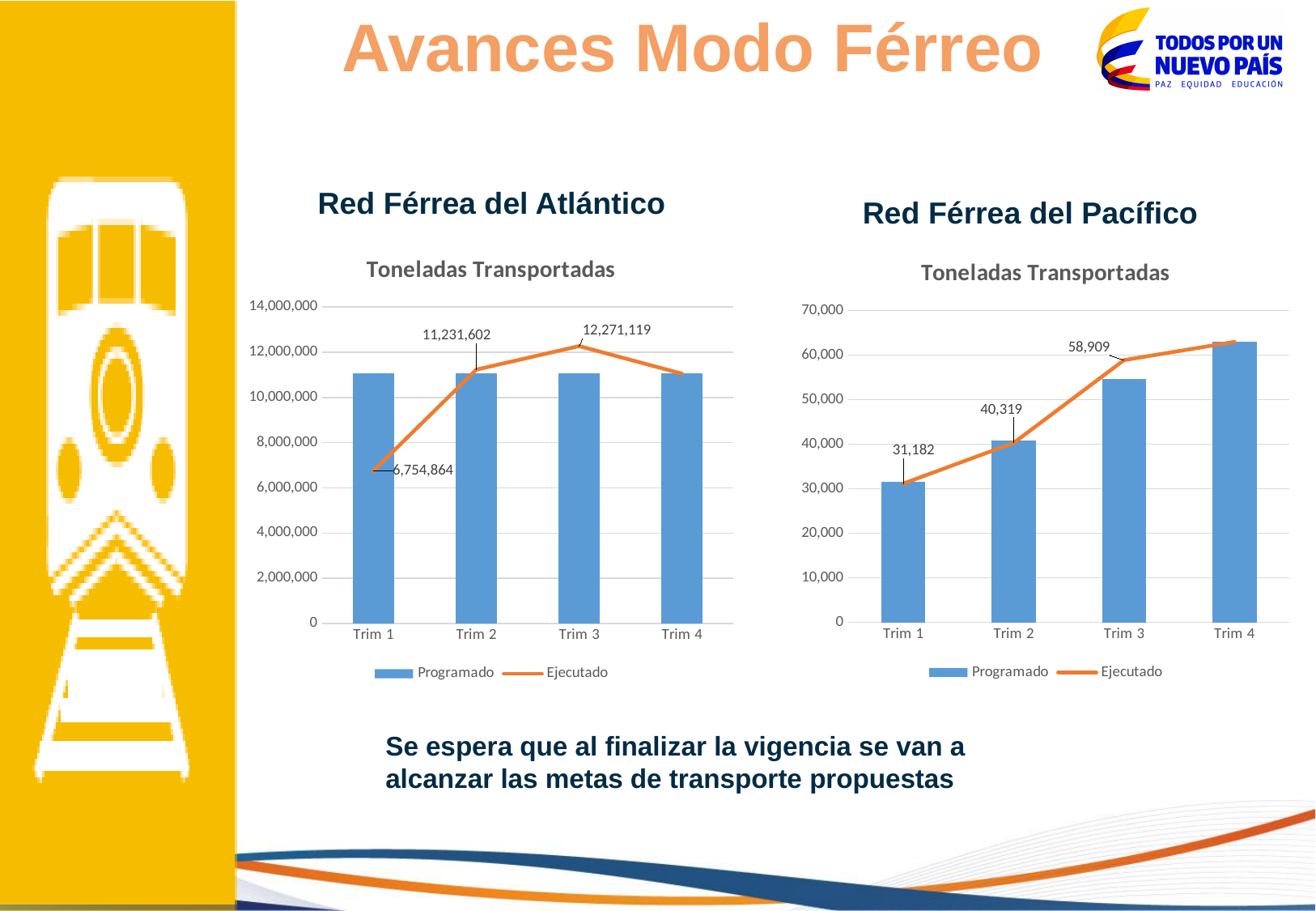
In the Red Férrea del Pacífico chart, does the Ejecutado line rise or fall from Trim 1 to Trim 4? rises In the Red Férrea del Atlántico chart, what is the difference between the Ejecutado values for Trim 3 and Trim 2? 1,039,517 In the Red Férrea del Pacífico chart, how much higher is the Ejecutado value for Trim 2 than for Trim 1? 9,137 In the Red Férrea del Pacífico chart, is the Programado value for Trim 4 greater or less than 60,000? greater In the Red Férrea del Atlántico chart, what is the Ejecutado value for Trim 1? 6,754,864 In the Red Férrea del Atlántico chart, which quarter has the highest Ejecutado value? Trim 3 In the Red Férrea del Atlántico chart, what is the Ejecutado value for Trim 3? 12,271,119 What kind of chart is the Red Férrea del Pacífico chart? Combined bar and line chart In the Red Férrea del Pacífico chart, what is the Ejecutado value for Trim 2? 40,319 How many series does the legend of the Red Férrea del Atlántico chart list? 2 In the Red Férrea del Pacífico chart, what is the Ejecutado value for Trim 3? 58,909 In the Red Férrea del Atlántico chart, is the Ejecutado value for Trim 1 greater or less than 8,000,000? less